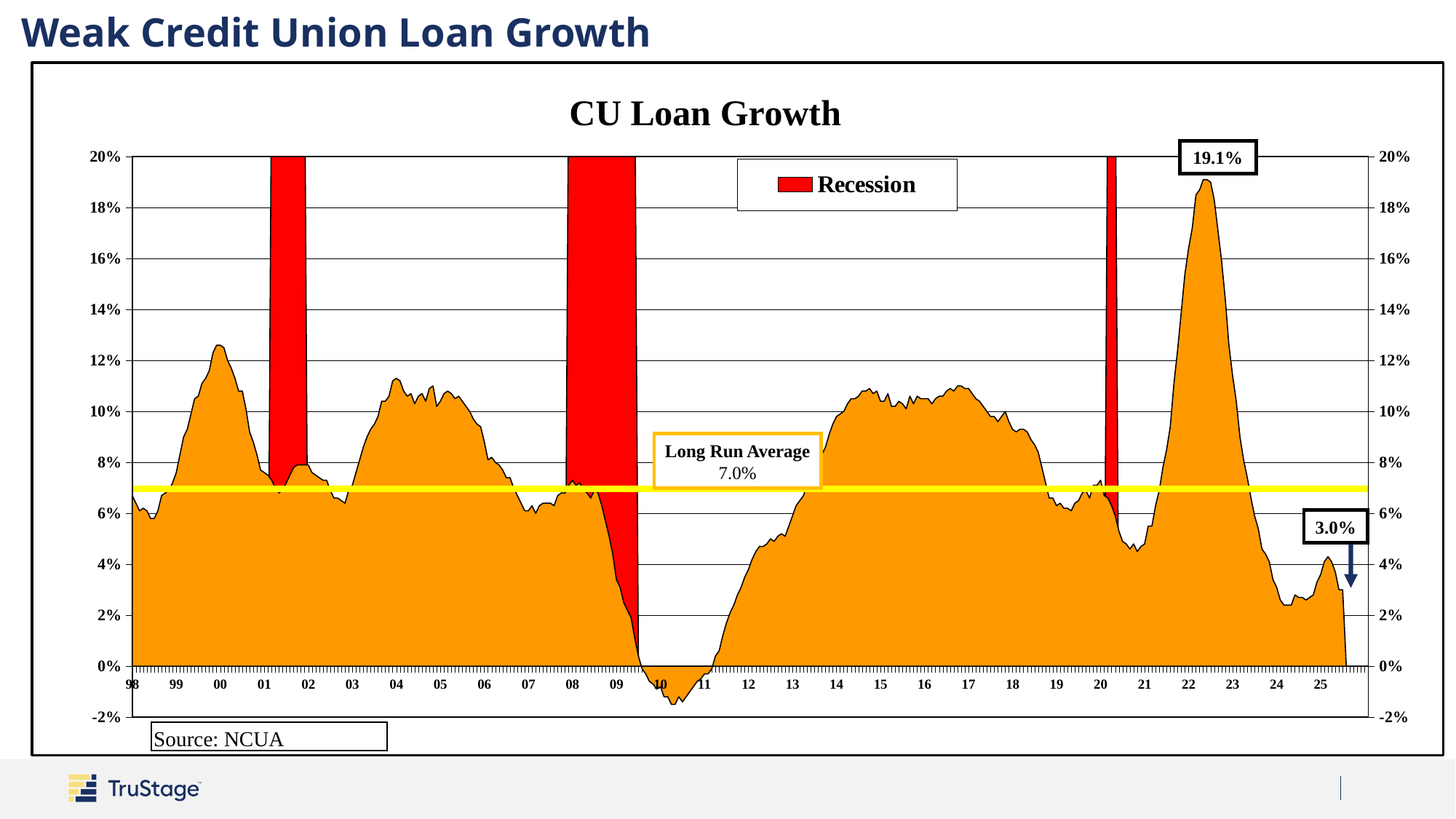
Which peak is higher: the one around 2000 or the one around 2022? 2022 Is the CU loan growth value around 2010 greater or less than 0%? less How many entries does the chart legend list? 1 What is the peak value of CU loan growth labeled on the chart? 19.1% What is the long run average of CU loan growth shown on the chart? 7.0% Around which year does CU loan growth reach its lowest point on the chart? 10 What is the most recent CU loan growth value labeled on the chart? 3.0% How much higher is the labeled peak of 19.1% than the long run average of 7.0%? 12.1 percentage points What kind of chart is shown on the slide? Area chart Around which year does CU loan growth reach its highest point on the chart? 22 What is the difference between the labeled peak value (19.1%) and the latest value (3.0%)? 16.1 percentage points What is the title of the chart on the slide? CU Loan Growth